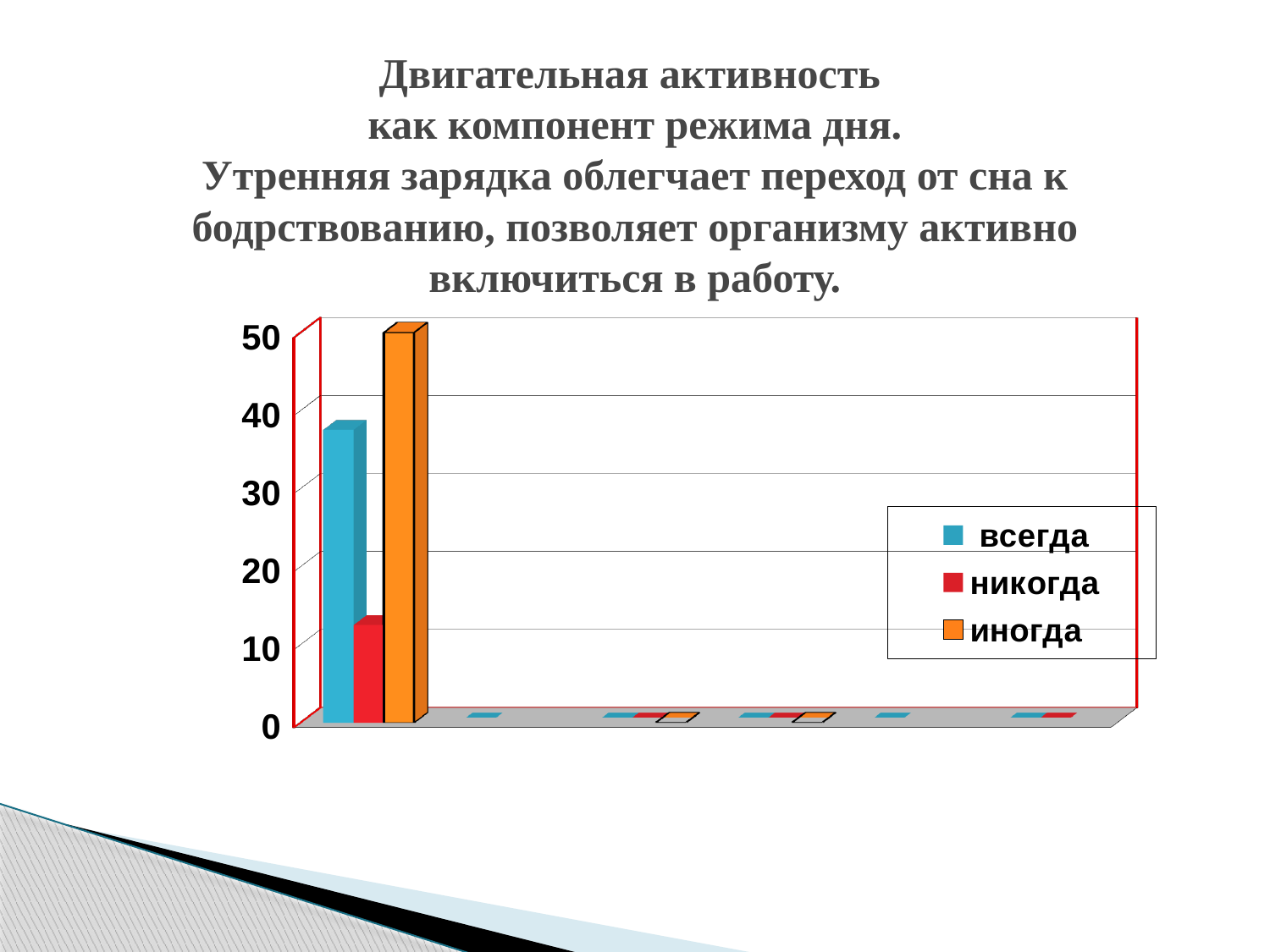
Is the value for иногда greater or less than 40? greater What colour represents the series всегда in the legend? blue Which is larger, the bar for всегда or the bar for никогда? всегда Is the value for никогда greater or less than 20? less Which series has the tallest bar? иногда Which is larger, the bar for иногда or the bar for всегда? иногда How many series does the legend list? 3 What is the highest value shown on the vertical axis? 50 Is the value for всегда greater or less than 30? greater Which series has the shortest bar? никогда What kind of chart is shown on the slide? bar chart